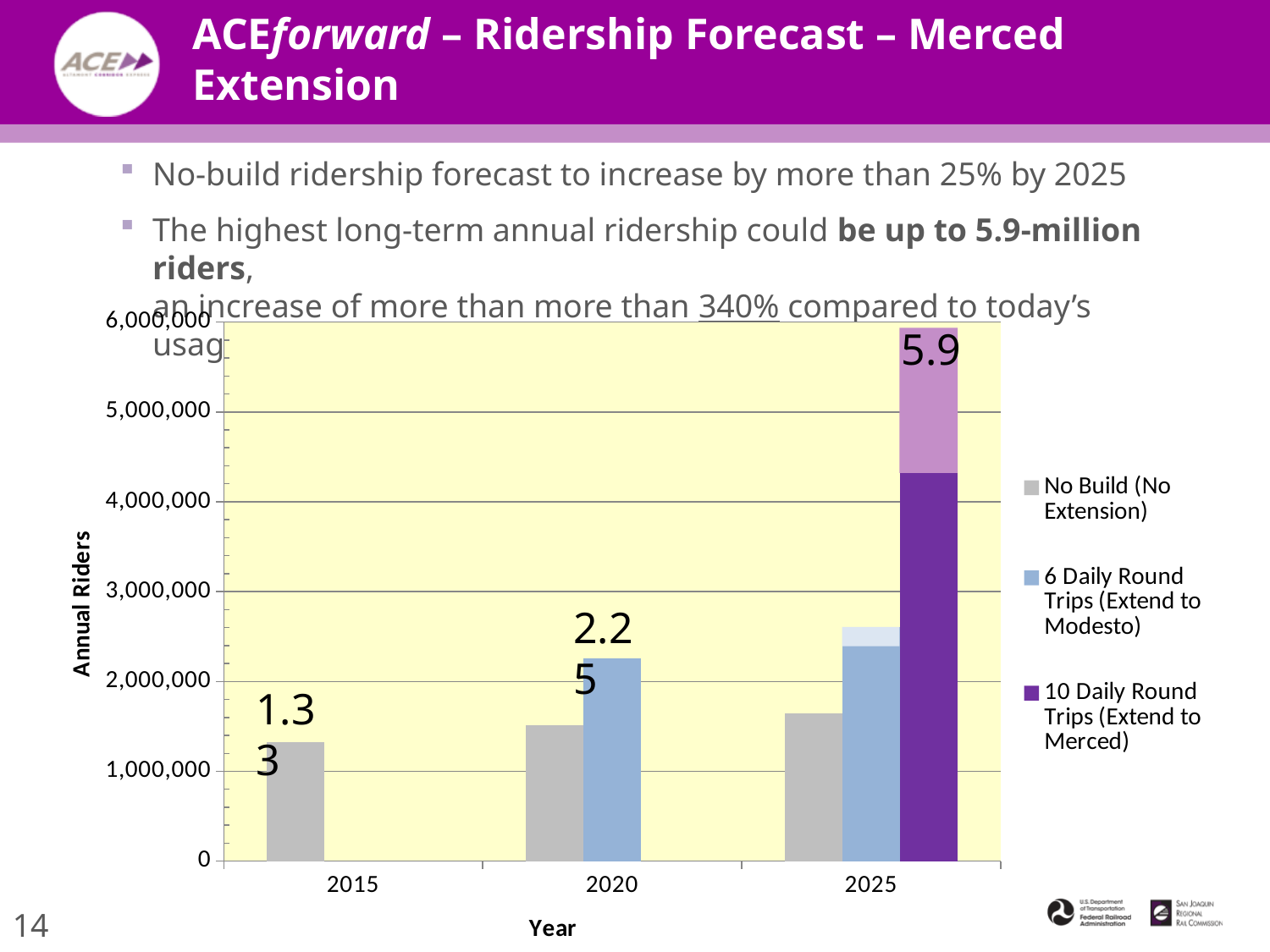
In 2025, which is larger: the 6 Daily Round Trips (Extend to Modesto) value or the 10 Daily Round Trips (Extend to Merced) value? 10 Daily Round Trips (Extend to Merced) Which year has the tallest bar in the chart? 2025 What number is printed on the tallest bar in the chart? 5.9 What kind of chart is shown on the slide? bar chart Is the 10 Daily Round Trips (Extend to Merced) value for 2025 greater or less than 5,000,000? greater Do the No Build (No Extension) values rise or fall from 2015 to 2025? rise How many series does the chart legend list? 3 Is the 6 Daily Round Trips (Extend to Modesto) value for 2025 greater or less than 2,000,000? greater Is the No Build (No Extension) value for 2015 greater or less than 2,000,000? less What is the title of the chart's vertical axis? Annual Riders How many years are shown on the x axis of the chart? 3